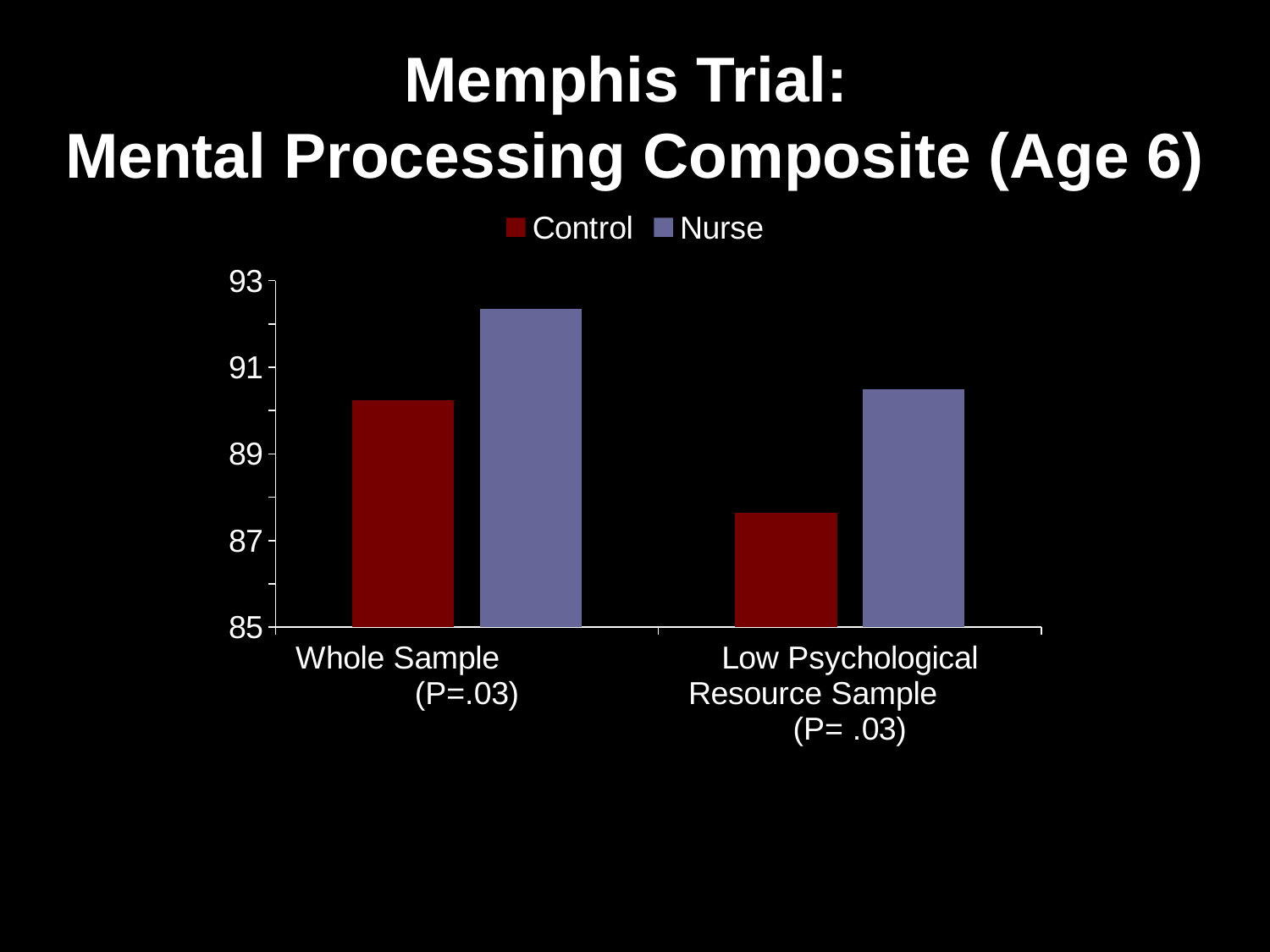
How many categories are shown on the x axis? 2 In the Whole Sample group, which is larger, Control or Nurse? Nurse Is the Nurse value for the Low Psychological Resource Sample greater or less than 89? greater Which bar is the highest in the chart? Nurse, Whole Sample How many series does the legend list? 2 Is the Control value for the Whole Sample greater or less than 91? less Is the Control value for the Low Psychological Resource Sample greater or less than 89? less What kind of chart is shown on the slide? bar chart What colour represents the Control series in the legend? dark red In the Low Psychological Resource Sample group, which is larger, Control or Nurse? Nurse Which bar is the lowest in the chart? Control, Low Psychological Resource Sample